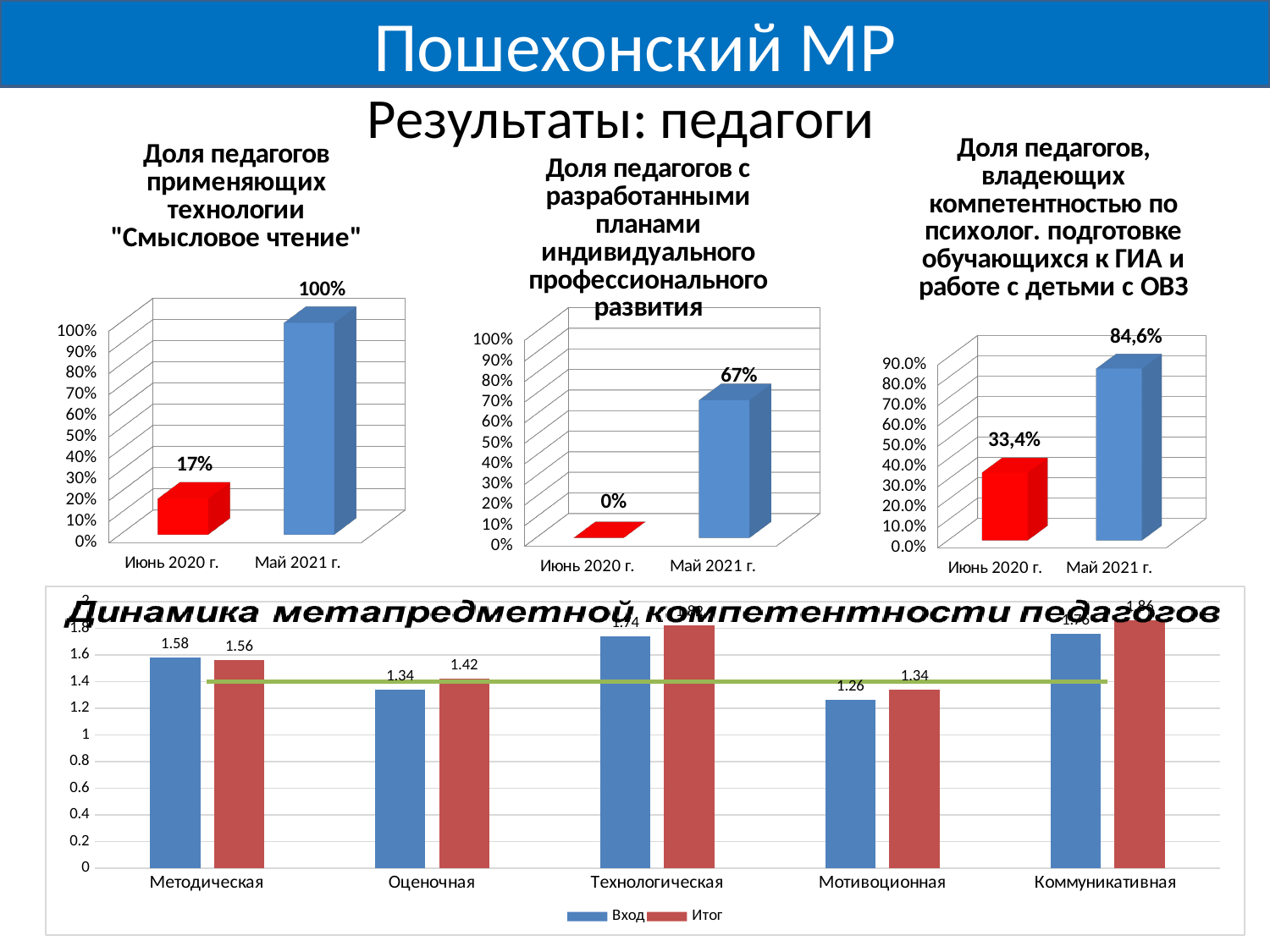
In the chart "Доля педагогов с разработанными планами индивидуального профессионального развития", what is the value for Май 2021 г.? 67% In the chart "Динамика метапредметной компетентности педагогов", what is the Итог value for Оценочная? 1.42 In the chart "Доля педагогов применяющих технологии "Смысловое чтение"", what is the value for Июнь 2020 г.? 17% In the chart "Доля педагогов с разработанными планами индивидуального профессионального развития", what is the value for Июнь 2020 г.? 0% In the chart "Динамика метапредметной компетентности педагогов", what is the Вход value for Методическая? 1.58 In the chart "Динамика метапредметной компетентности педагогов", what is the difference between the Итог and Вход values for Мотивоционная? 0.08 In the chart "Динамика метапредметной компетентности педагогов", how many categories are shown on the x axis? 5 In the chart "Доля педагогов применяющих технологии "Смысловое чтение"", which period has the higher value, Июнь 2020 г. or Май 2021 г.? Май 2021 г. In the chart "Доля педагогов, владеющих компетентностью по психолог. подготовке обучающихся к ГИА и работе с детьми с ОВЗ", what is the value for Июнь 2020 г.? 33,4% In the chart "Динамика метапредметной компетентности педагогов", how many series does the legend list? 2 In the chart "Доля педагогов применяющих технологии "Смысловое чтение"", what is the value for Май 2021 г.? 100% In the chart "Доля педагогов, владеющих компетентностью по психолог. подготовке обучающихся к ГИА и работе с детьми с ОВЗ", what is the difference between Май 2021 г. and Июнь 2020 г.? 51,2%